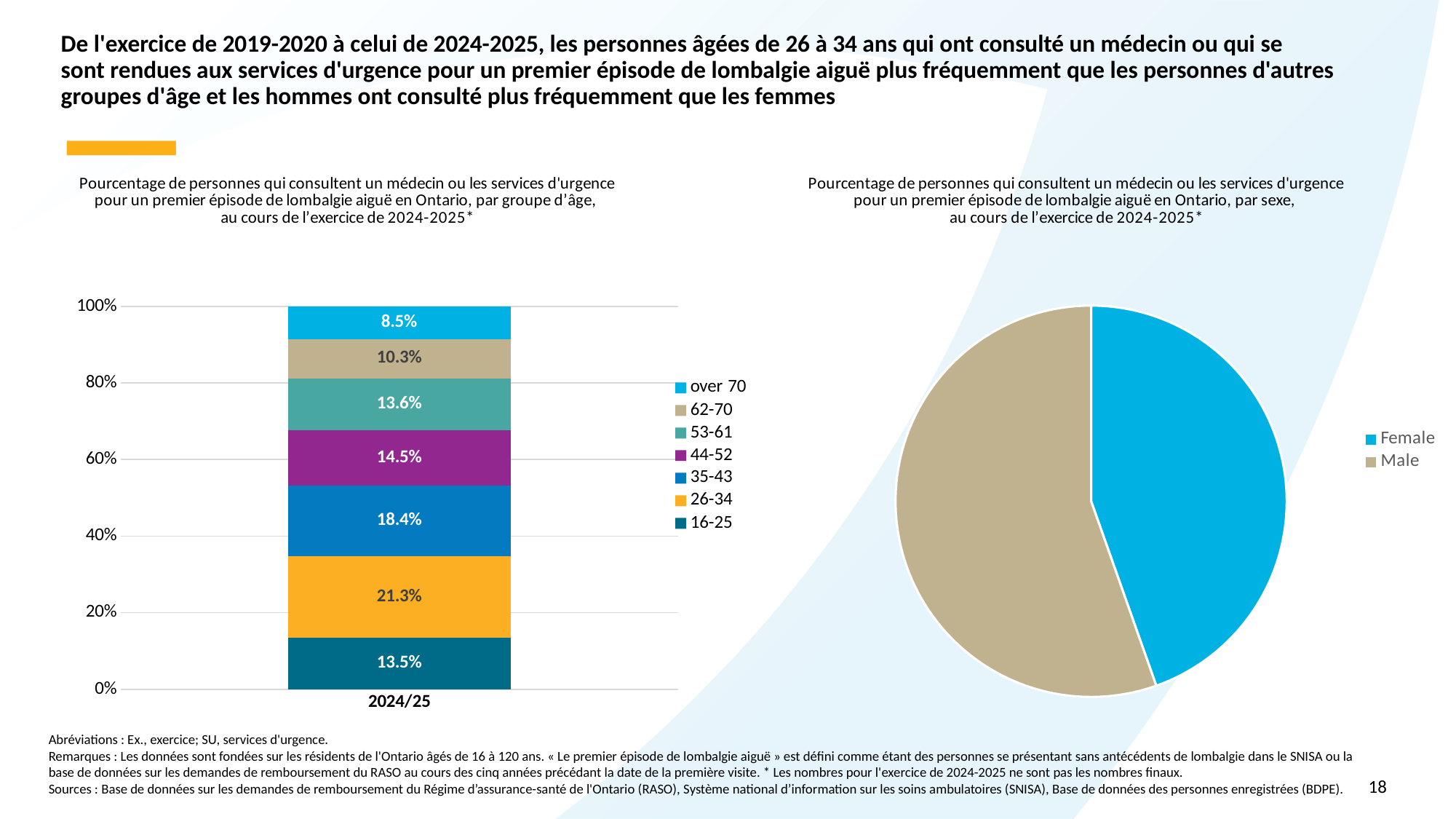
In the left chart (by age group), which is larger: the share for 44-52 or the share for 53-61? 44-52 In the right chart (by sex), which slice is larger: Female or Male? Male In the left chart (by age group), what percentage is shown for the 35-43 age group? 18.4% In the left chart (by age group), what is the difference between the 26-34 share and the 16-25 share? 7.8% In the left chart (by age group), what percentage is shown for the 26-34 age group? 21.3% In the left chart (by age group), what percentage is shown for the over 70 age group? 8.5% In the left chart (by age group), how many age groups does the legend list? 7 In the left chart (by age group), which age group has the smallest share? over 70 In the left chart (by age group), what percentage is shown for the 16-25 age group? 13.5% What kind of chart is the right chart (by sex)? Pie chart In the left chart (by age group), which age group has the largest share? 26-34 What kind of chart is the left chart (by age group)? Stacked bar chart